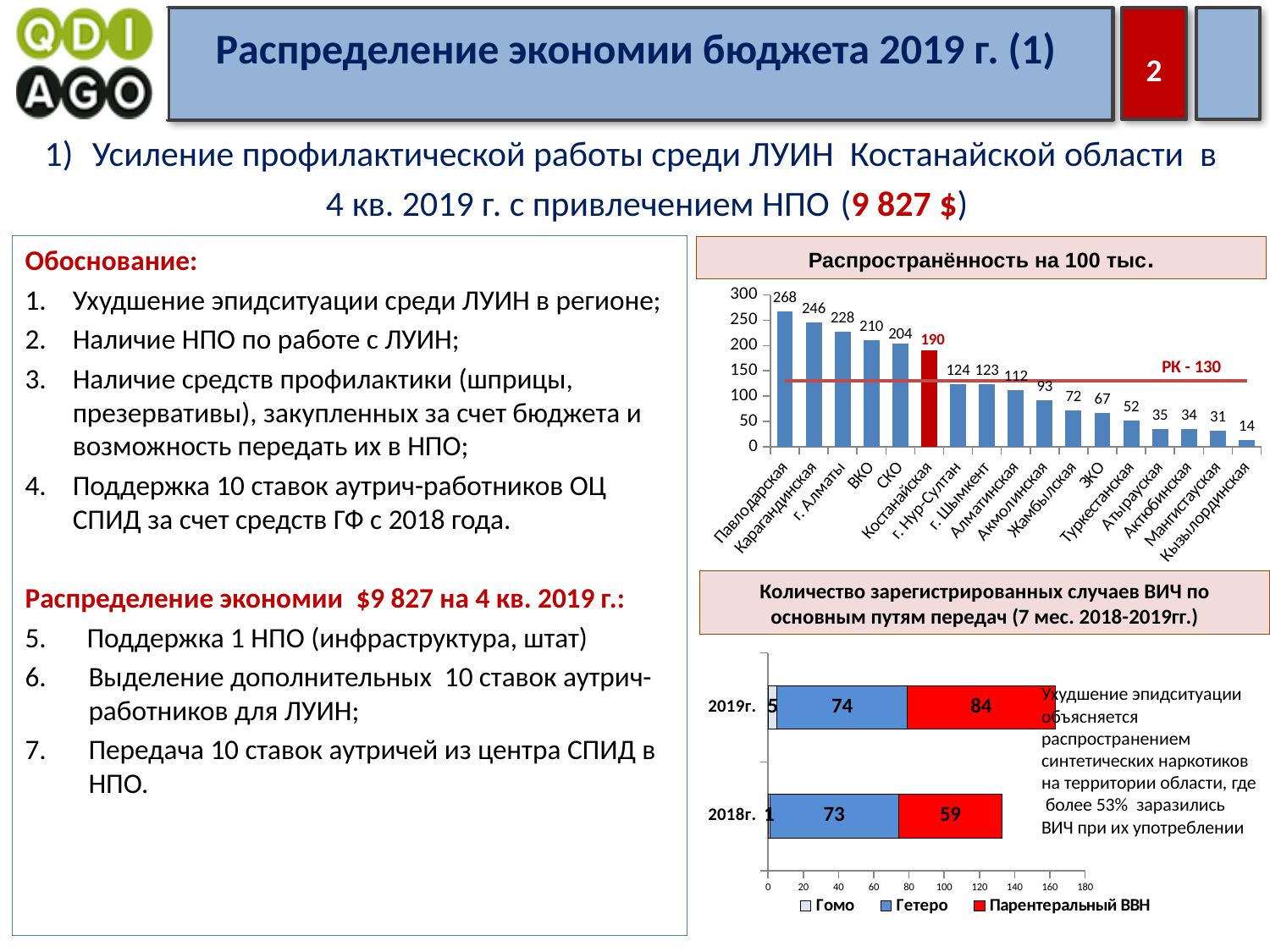
In the chart 'Распространённость на 100 тыс.', how many regions are shown on the x axis? 17 In the chart 'Распространённость на 100 тыс.', what is the difference between the values for Павлодарская and Карагандинская? 22 In the chart 'Распространённость на 100 тыс.', which is larger: the value for г. Нур-Султан or the value for Акмолинская? г. Нур-Султан In the chart 'Распространённость на 100 тыс.', which region has the lowest value? Кызылординская In the chart 'Количество зарегистрированных случаев ВИЧ по основным путям передач', how many series does the legend list? 3 What kind of chart is 'Распространённость на 100 тыс.'? Bar chart In the chart 'Распространённость на 100 тыс.', which region has the highest value? Павлодарская In the chart 'Количество зарегистрированных случаев ВИЧ по основным путям передач', what is the total of the stacked bar for 2018г.? 133 In the chart 'Количество зарегистрированных случаев ВИЧ по основным путям передач', what is the value for Парентеральный ВВН in 2019г.? 84 In the chart 'Распространённость на 100 тыс.', what is the value for Костанайская? 190 In the chart 'Количество зарегистрированных случаев ВИЧ по основным путям передач', what is the difference between the Парентеральный ВВН values for 2019г. and 2018г.? 25 In the chart 'Распространённость на 100 тыс.', what value is marked by the horizontal reference line labelled РК? 130